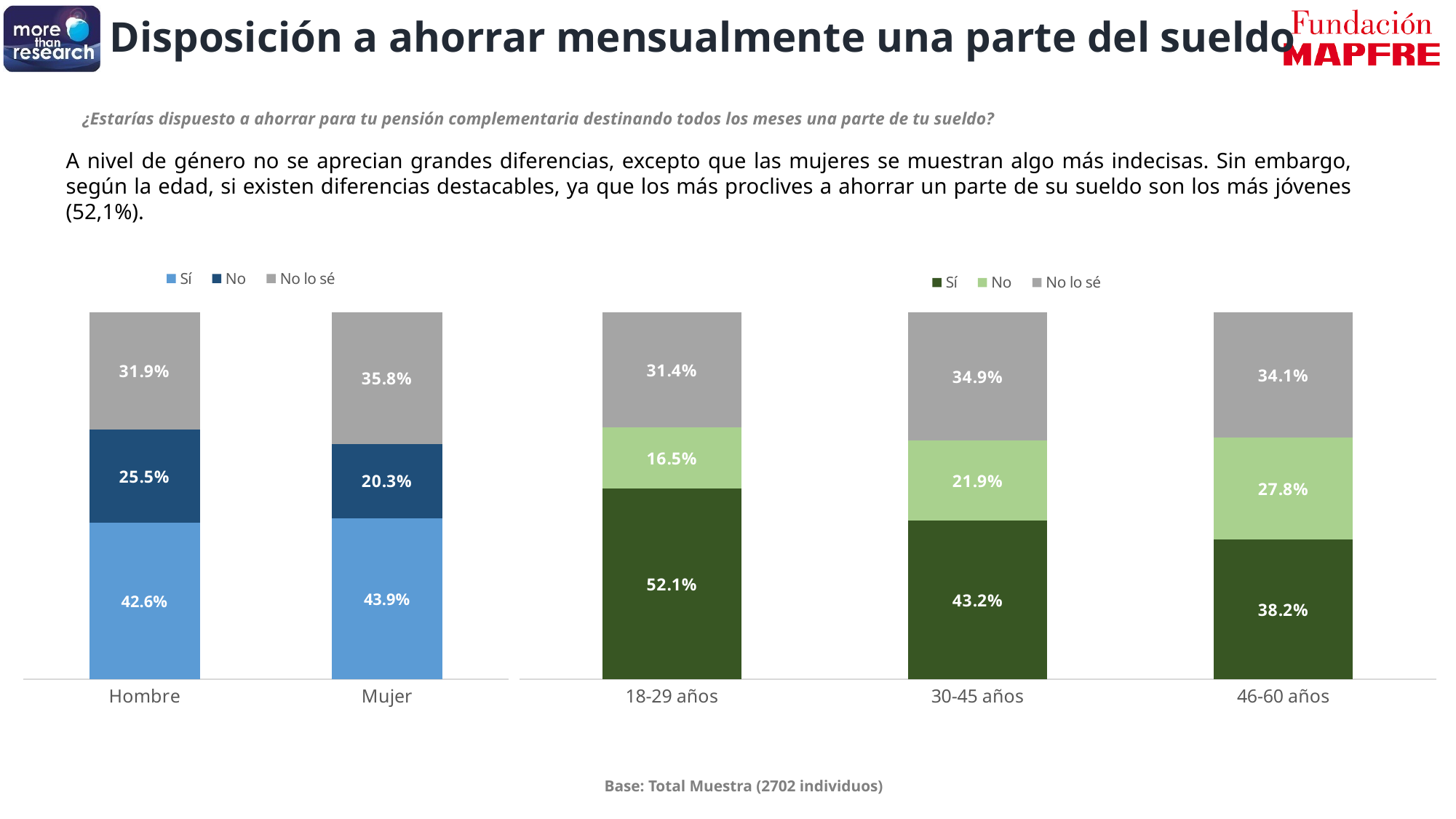
How many age groups are shown in the right chart? 3 How many series does the legend of the left chart list? 3 In the right chart (by age), is the 'No lo sé' value larger for 30-45 años or 46-60 años? 30-45 años What type of chart is used on this slide? Stacked bar chart In the left chart (by gender), what is the difference between the 'No' values for Hombre and Mujer? 5.2% In the right chart (by age), what is the 'Sí' value for 18-29 años? 52.1% In the right chart (by age), which age group has the highest 'Sí' value? 18-29 años In the right chart (by age), what is the total of the stacked bar for 30-45 años? 100% In the right chart (by age), which age group has the lowest 'No' value? 18-29 años In the left chart (by gender), what is the 'No lo sé' value for Mujer? 35.8% In the right chart (by age), what is the 'No' value for 46-60 años? 27.8% In the left chart (by gender), what is the 'Sí' value for Hombre? 42.6%